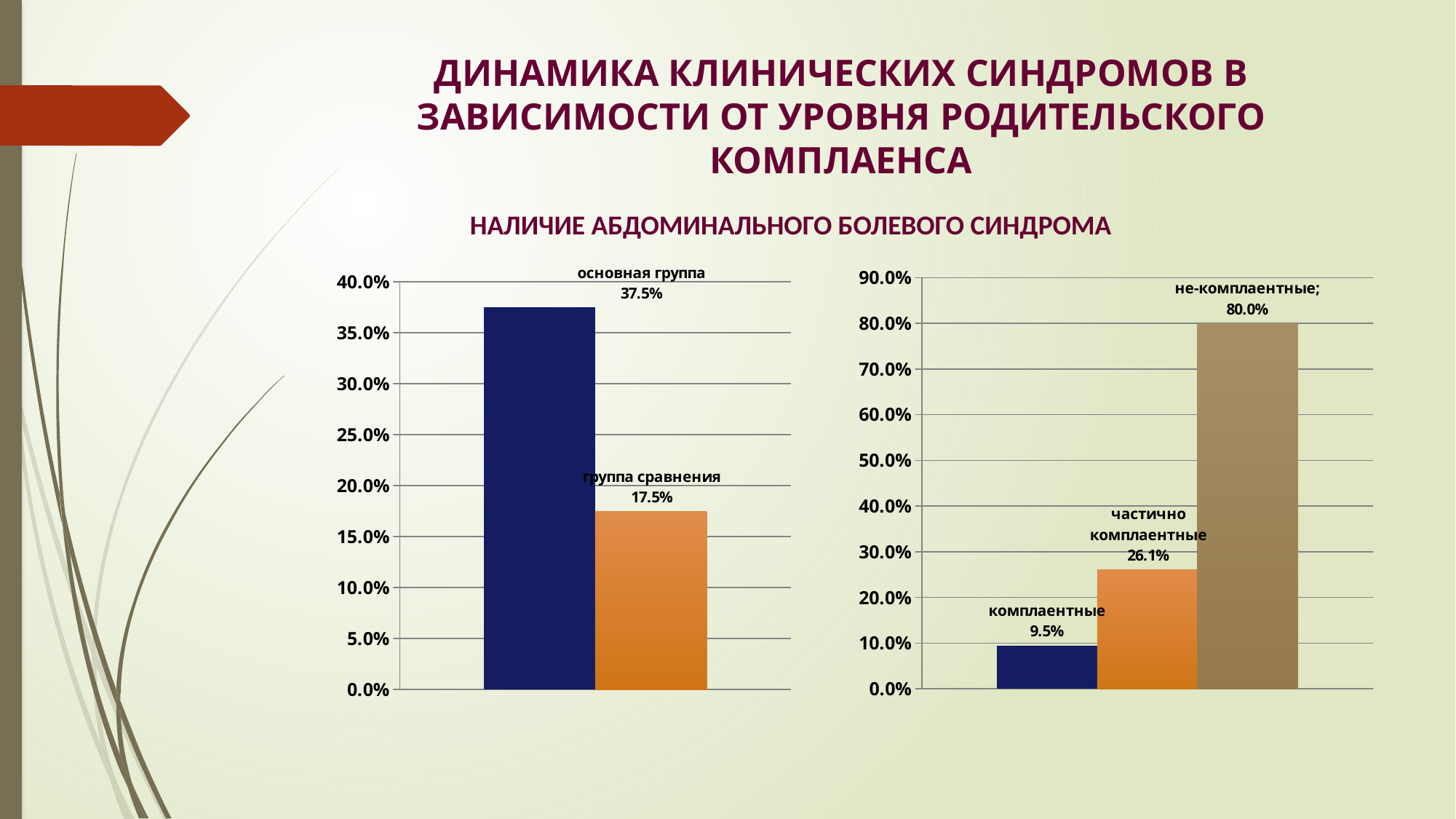
In the right chart, what is the difference between не-комплаентные and частично комплаентные? 53.9% What type of chart is the left chart? bar chart In the left chart, what is the value for основная группа? 37.5% How many bars are in the right chart? 3 In the left chart, which bar is higher: основная группа or группа сравнения? основная группа In the right chart, which category has the lowest value? комплаентные In the left chart, what is the value for группа сравнения? 17.5% In the right chart, what is the value for частично комплаентные? 26.1% In the right chart, what is the value for не-комплаентные? 80.0% In the right chart, which category has the highest value? не-комплаентные In the right chart, what is the value for комплаентные? 9.5% In the left chart, what is the difference between основная группа and группа сравнения? 20.0%